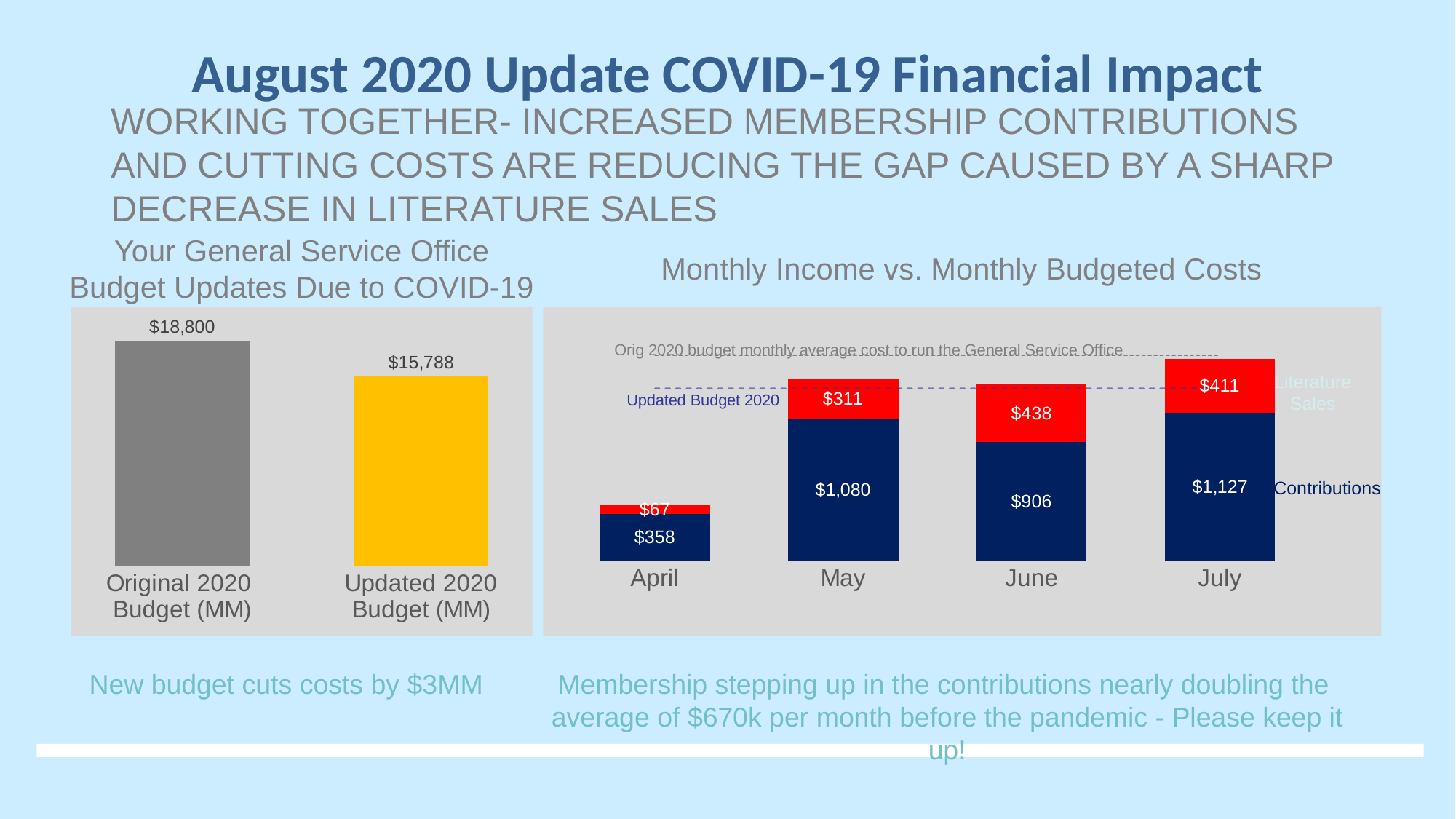
In the 'Monthly Income vs. Monthly Budgeted Costs' chart, what is the Contributions value for May? $1,080 In the 'Monthly Income vs. Monthly Budgeted Costs' chart, is the Contributions value for June larger or smaller than for May? Smaller In the 'Monthly Income vs. Monthly Budgeted Costs' chart, how many months are shown on the x axis? 4 In the 'Monthly Income vs. Monthly Budgeted Costs' chart, what is the total of the stacked bar for July? $1,538 In the 'Monthly Income vs. Monthly Budgeted Costs' chart, what is the total of the stacked bar for April? $425 In the 'Monthly Income vs. Monthly Budgeted Costs' chart, which month has the highest Contributions value? July What kind of chart is 'Your General Service Office Budget Updates Due to COVID-19'? Bar chart In the 'Your General Service Office Budget Updates Due to COVID-19' chart, what is the value of the Updated 2020 Budget (MM)? $15,788 In the 'Monthly Income vs. Monthly Budgeted Costs' chart, what is the Literature Sales value for June? $438 In the 'Monthly Income vs. Monthly Budgeted Costs' chart, which month has the lowest Literature Sales value? April In the 'Your General Service Office Budget Updates Due to COVID-19' chart, what is the value of the Original 2020 Budget (MM)? $18,800 In the 'Your General Service Office Budget Updates Due to COVID-19' chart, what is the difference between the Original 2020 Budget and the Updated 2020 Budget? $3,012